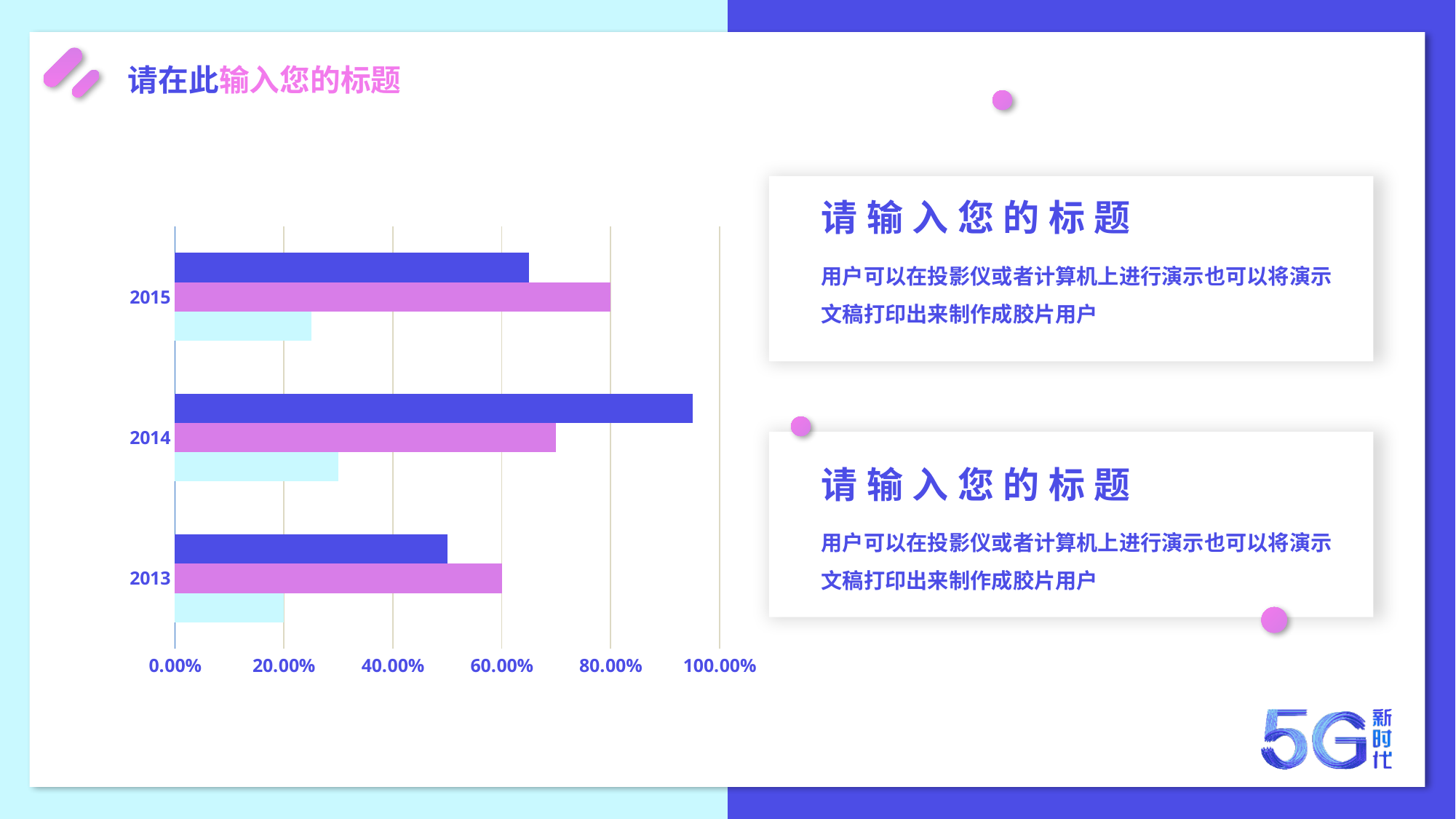
Which year has the longest dark blue bar? 2014 What kind of chart is shown on the slide? bar chart How many bars are drawn for each year on the chart? 3 Is the value of the pink bar for 2014 greater or less than 80.00%? less Which is larger, the pink bar for 2015 or the pink bar for 2013? 2015 Is the value of the dark blue bar for 2014 greater or less than 80.00%? greater Which is larger for 2013, the dark blue bar or the pink bar? the pink bar What is the highest value labelled on the chart's horizontal axis? 100.00% How many categories (years) are shown on the chart's vertical axis? 3 Is the value of the dark blue bar for 2015 greater or less than 60.00%? greater Which year has the shortest light cyan bar? 2013